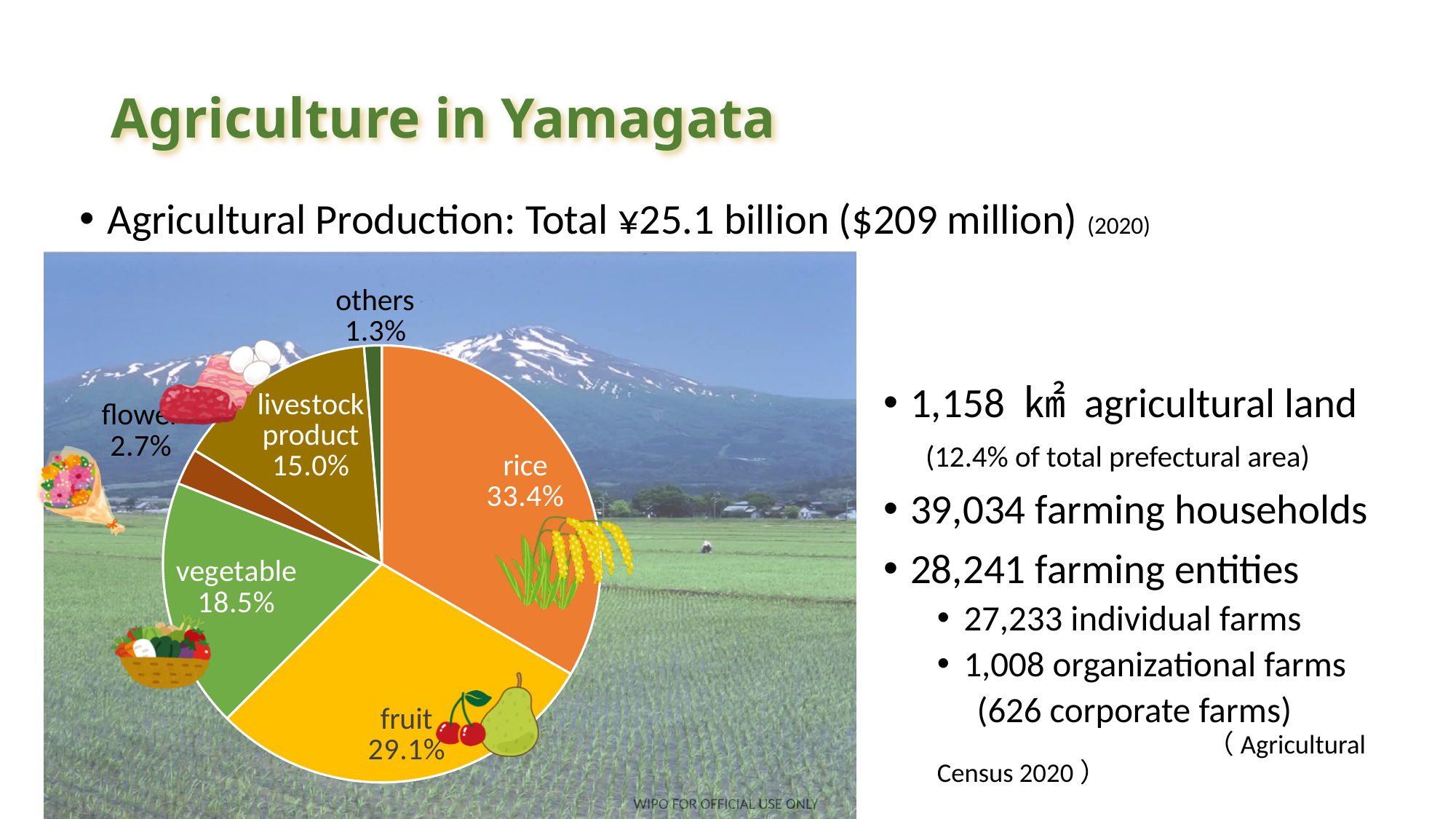
Which category has the largest slice of the pie? rice What is the difference in percentage points between rice and fruit? 4.3 Which is larger, the vegetable slice or the livestock product slice? vegetable What is the value shown for vegetable? 18.5% What percentage of the pie is fruit? 29.1% What kind of chart is shown on the slide? pie chart What is the value shown for the others slice? 1.3% What is the combined share of rice and fruit? 62.5% What share of agricultural production does rice account for? 33.4% What percentage is shown for livestock product? 15.0% Which category has the smallest slice of the pie? others How many slices does the pie chart have? 6